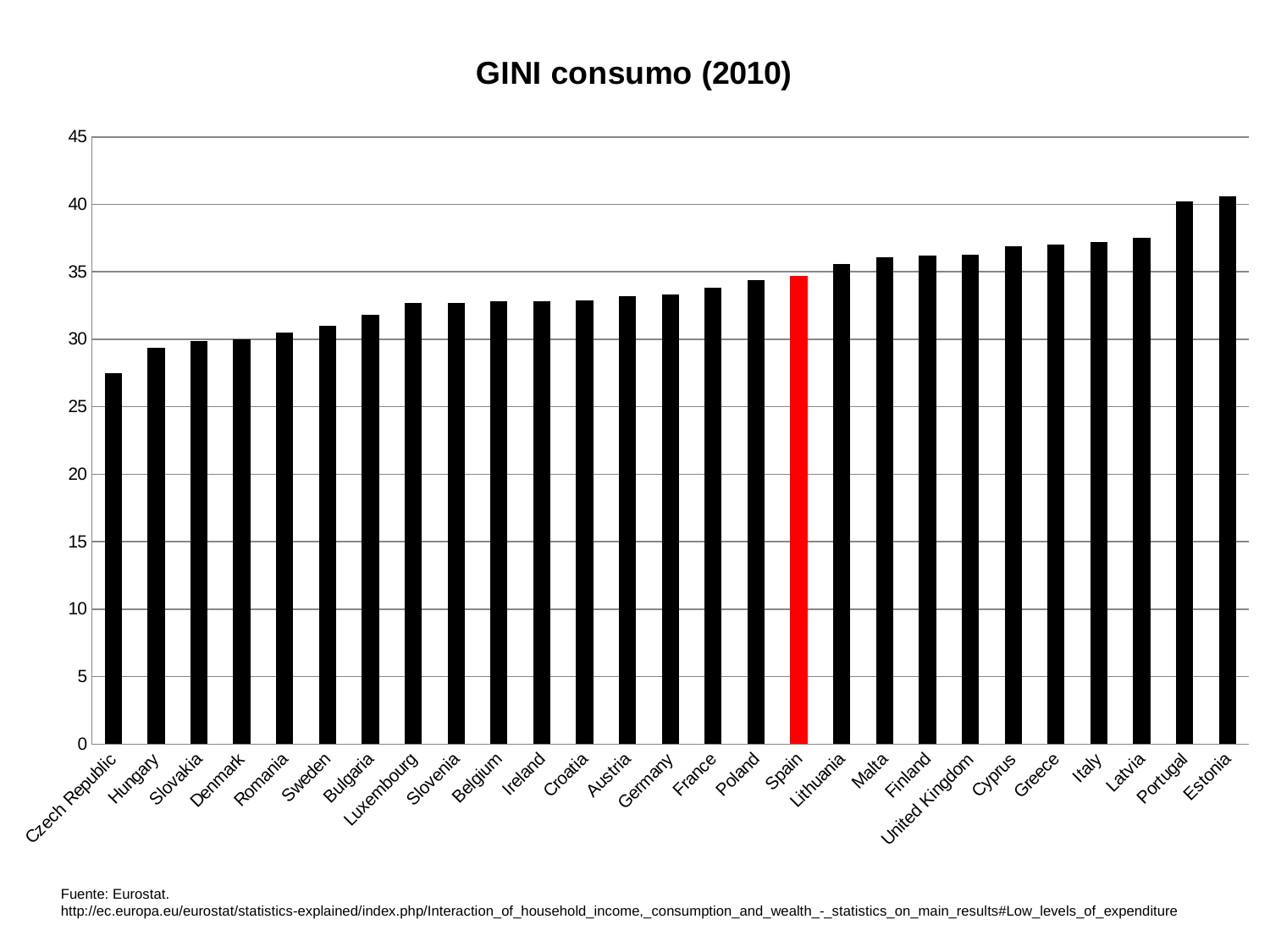
Which country has the lowest value in the chart? Czech Republic Is the value for Estonia greater or less than 40? greater What is the title of the chart? GINI consumo (2010) Is the value for Italy greater or less than 35? greater Is the value for Sweden greater or less than 30? greater What kind of chart is shown on the slide? bar chart How many countries are shown on the x axis of the chart? 27 Do the values generally rise or fall from left to right along the x axis? rise Which has the larger value, Spain or Czech Republic? Spain Which country's bar is coloured red in the chart? Spain